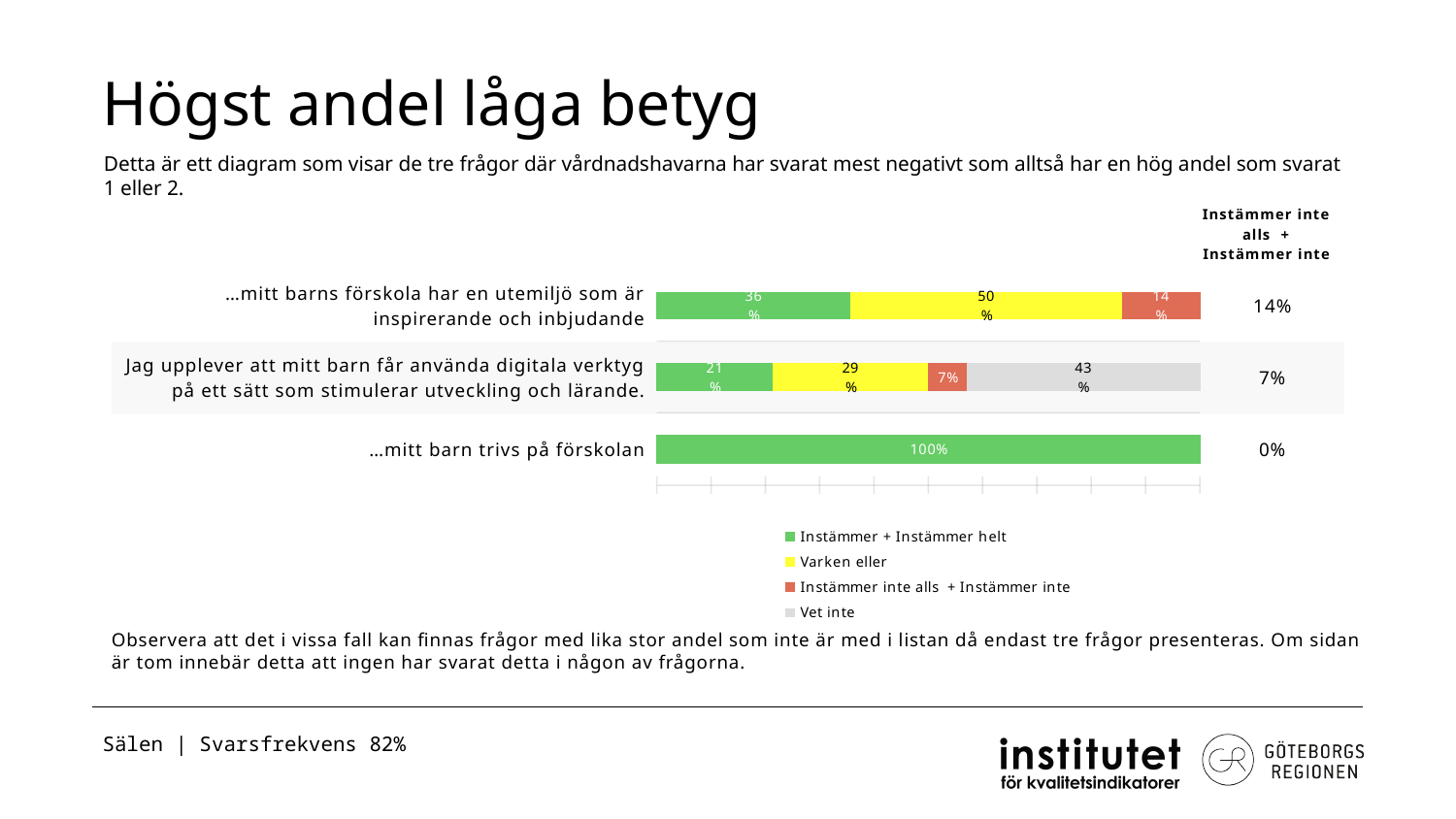
Which question has the lowest 'Instämmer inte alls + Instämmer inte' share? …mitt barn trivs på förskolan What is the 'Instämmer + Instämmer helt' share for '…mitt barn trivs på förskolan'? 100% What kind of chart is shown on the slide? stacked bar chart Which question has the highest 'Instämmer inte alls + Instämmer inte' share? …mitt barns förskola har en utemiljö som är inspirerande och inbjudande What is the difference between the 'Instämmer inte alls + Instämmer inte' share for the outdoor environment question (14%) and the digital tools question (7%)? 7% What is the 'Vet inte' share for 'Jag upplever att mitt barn får använda digitala verktyg på ett sätt som stimulerar utveckling och lärande.'? 43% How many series does the legend list? 4 What is the 'Varken eller' share for '…mitt barns förskola har en utemiljö som är inspirerande och inbjudande'? 50% How many questions (categories) are plotted in the chart? 3 What is the 'Instämmer + Instämmer helt' share for '…mitt barns förskola har en utemiljö som är inspirerande och inbjudande'? 36% What colour represents 'Vet inte' in the legend? grey Which is larger for the digital tools question: the 'Varken eller' share or the 'Instämmer + Instämmer helt' share? Varken eller